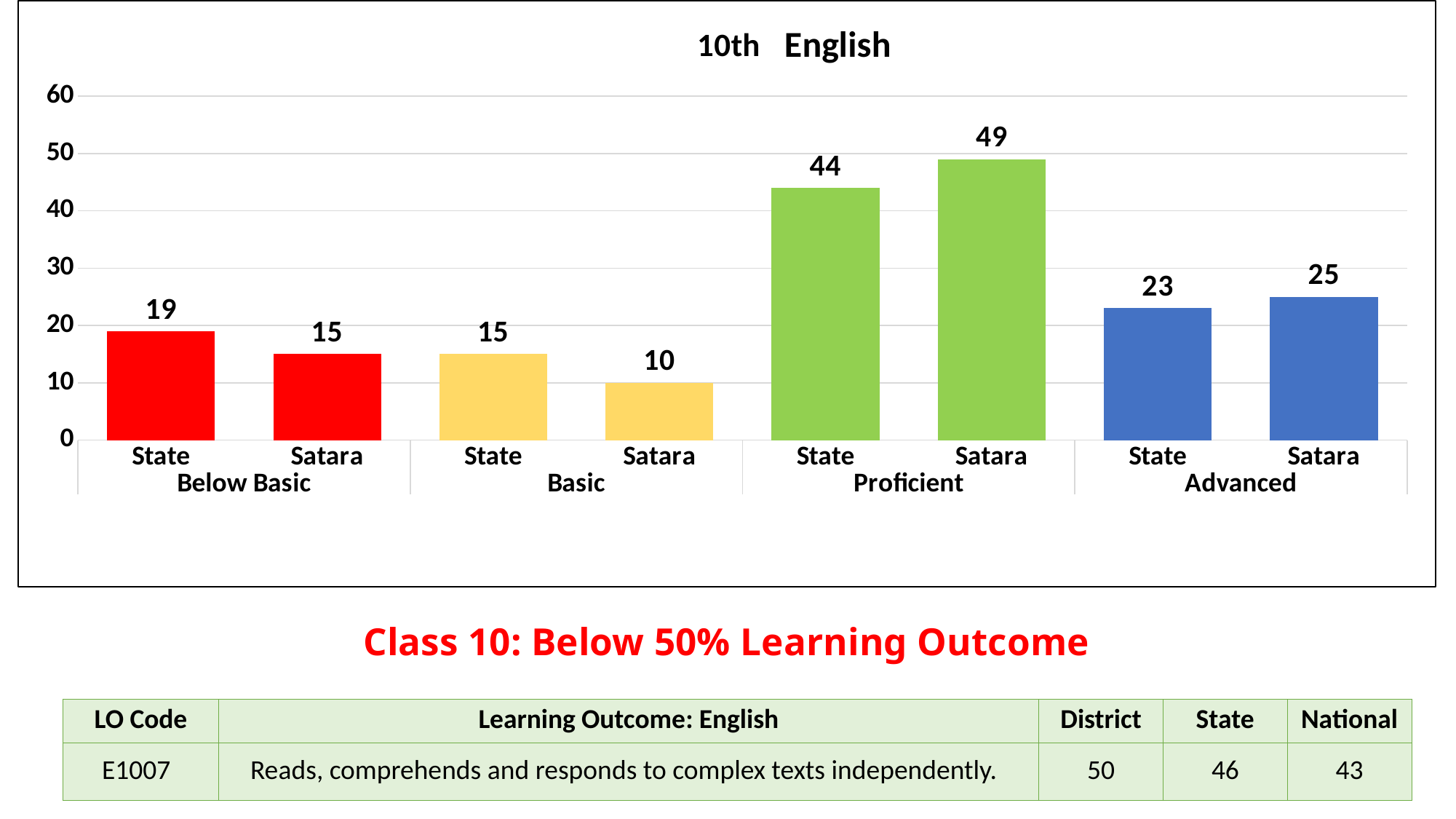
What type of chart is shown on the slide? Bar chart What is the value for Satara in the Proficient group? 49 What is the value for State in the Advanced group? 23 What is the value for Satara in the Basic group? 10 How many bars are plotted in the chart? 8 What is the difference between the Satara and State values in the Proficient group? 5 Is the value for State in the Proficient group greater or less than 40? greater Which is larger in the Below Basic group, State or Satara? State What is the title of the chart? 10th English Which bar has the highest value in the chart? Satara, Proficient What is the value for State in the Below Basic group? 19 Which bar has the lowest value in the chart? Satara, Basic